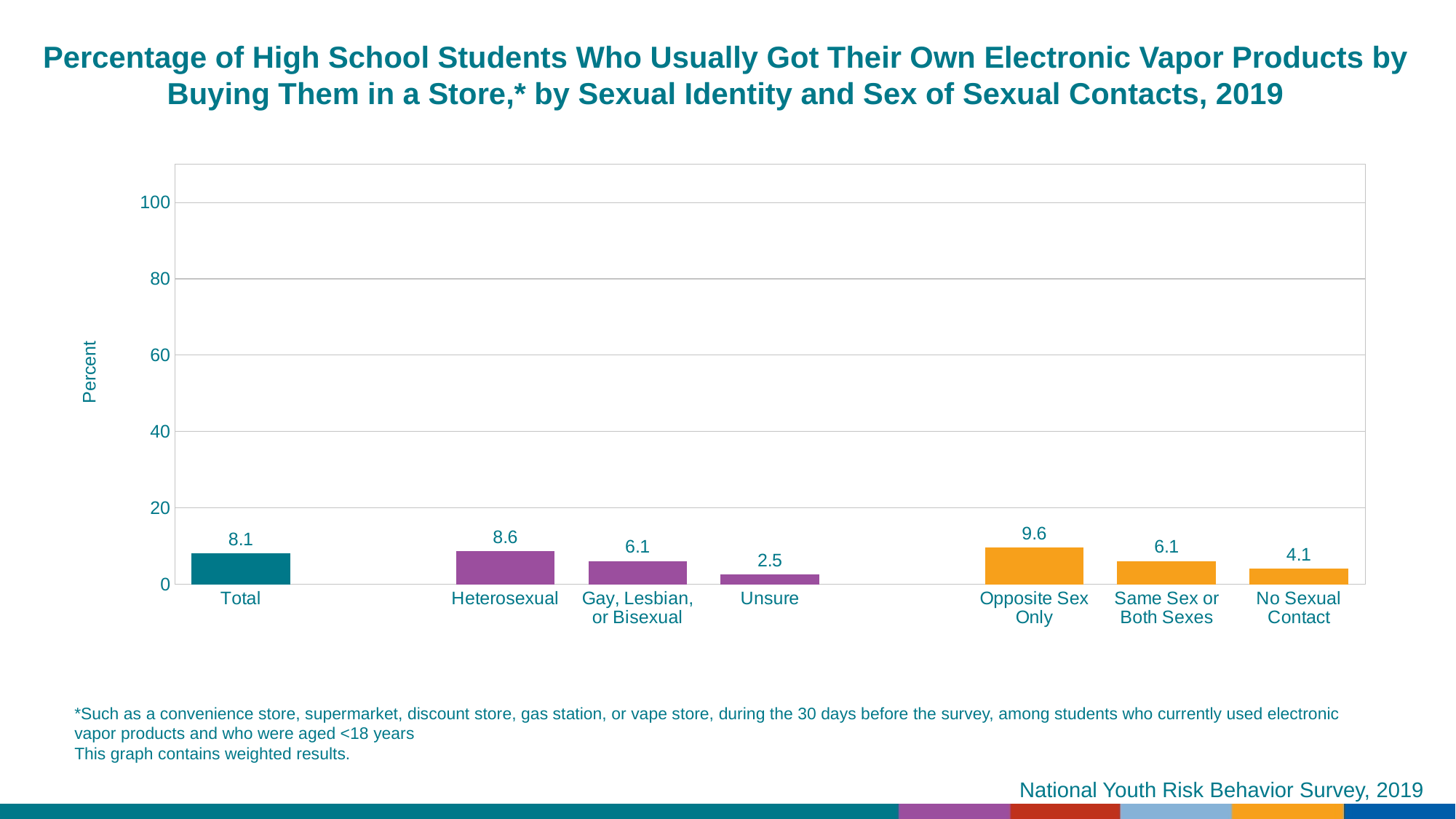
What is the difference between the values for Heterosexual and Unsure? 6.1 What is the value for Heterosexual? 8.6 What is the value for No Sexual Contact? 4.1 What is the value for Total? 8.1 How many categories are shown on the x axis? 7 Is the value for Opposite Sex Only greater or less than 20? less What is the difference between the values for Opposite Sex Only and No Sexual Contact? 5.5 What kind of chart is this? bar chart Which category has the highest value? Opposite Sex Only What is the value for Unsure? 2.5 Which category has the lowest value? Unsure Which is larger, the value for Heterosexual or the value for Total? Heterosexual